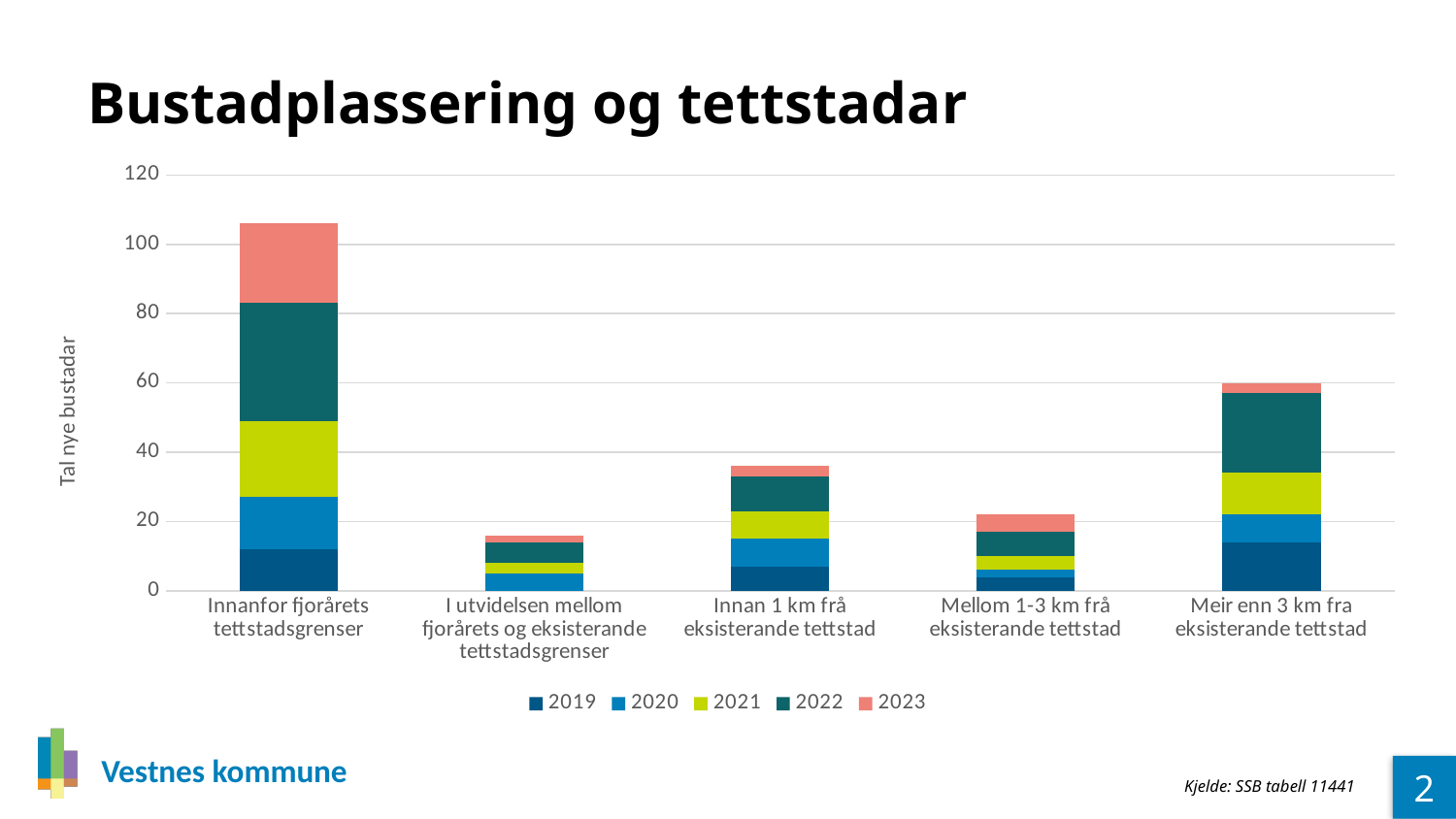
Is the total stacked bar for 'I utvidelsen mellom fjorårets og eksisterande tettstadsgrenser' greater or less than 20? less What is the title of the chart on the slide? Bustadplassering og tettstadar How many series does the chart's legend list? 5 What kind of chart is shown on the slide? Stacked bar chart Which category has the shortest stacked bar? I utvidelsen mellom fjorårets og eksisterande tettstadsgrenser Which category has the tallest stacked bar? Innanfor fjorårets tettstadsgrenser Is the total stacked bar for 'Innanfor fjorårets tettstadsgrenser' greater or less than 100? greater Is the total stacked bar for 'Innan 1 km frå eksisterande tettstad' greater or less than 40? less How many categories are shown along the x axis of the chart? 5 Which has the taller stacked bar: 'Innan 1 km frå eksisterande tettstad' or 'Mellom 1-3 km frå eksisterande tettstad'? Innan 1 km frå eksisterande tettstad What is the label on the vertical axis of the chart? Tal nye bustadar